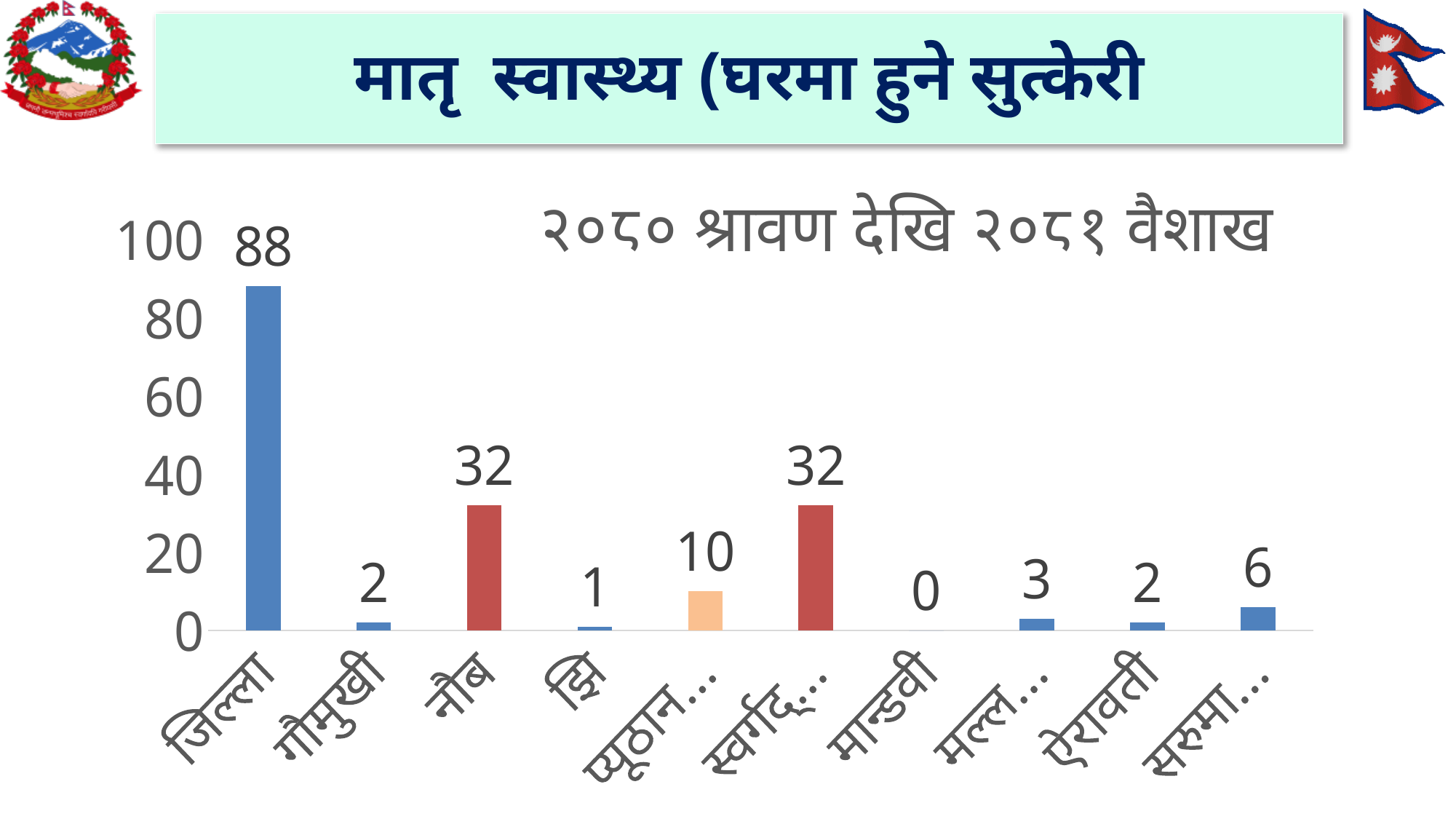
Which category has the lowest value? माण्डवी Which is larger, the value for नौब or the value for झि? नौब What is the value for ऐरावती? 2 Which category has the highest value? जिल्ला What is the value for माण्डवी? 0 What is the difference between the values for जिल्ला and नौब? 56 What kind of chart is shown on the slide? Bar chart What is the value for गौमुखी? 2 What is the title of the chart? २०८० श्रावण देखि २०८१ वैशाख What is the value for जिल्ला? 88 How many categories are shown on the x axis? 10 What is the value for नौब? 32